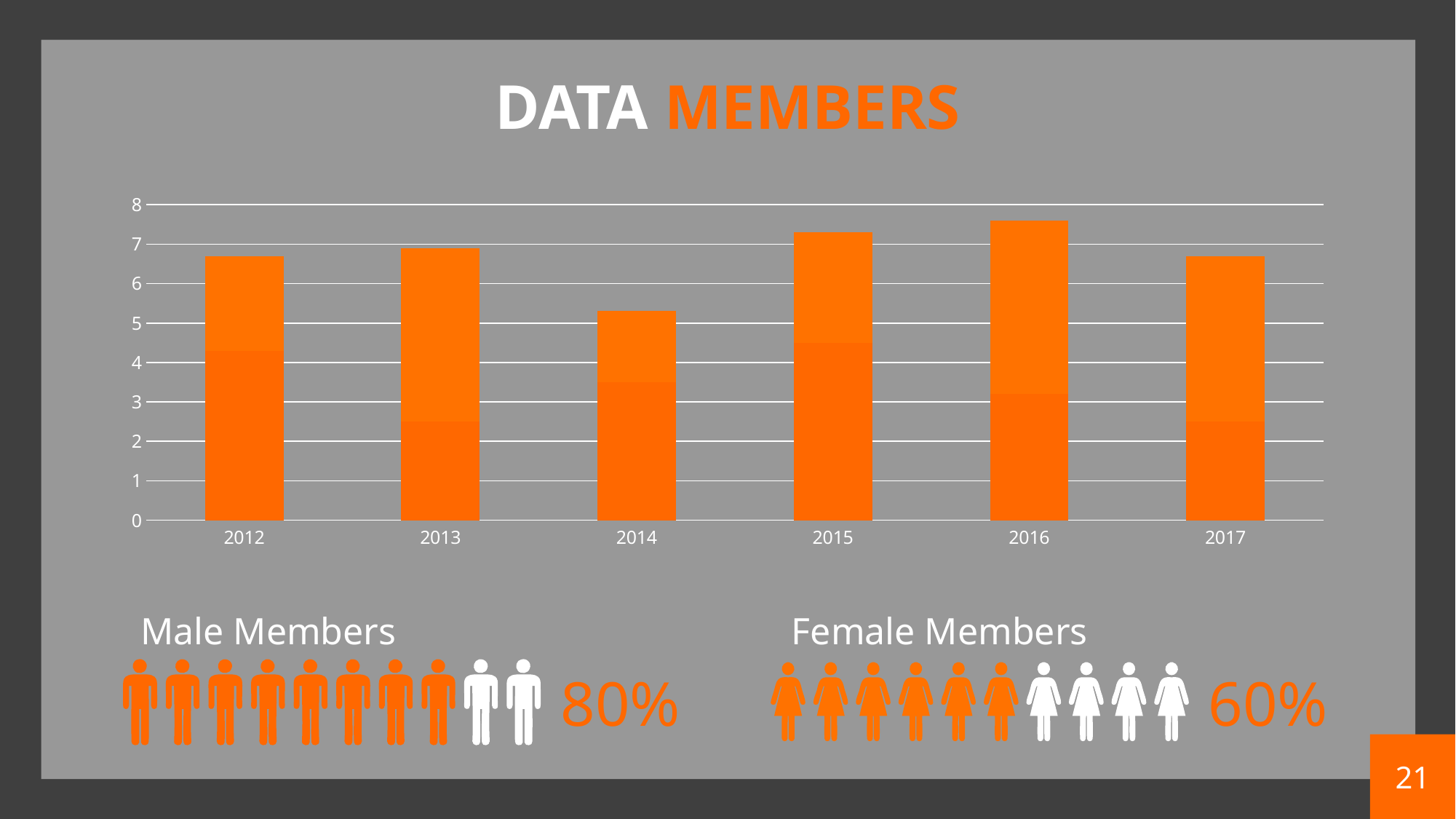
What is the title of the slide containing the chart? DATA MEMBERS Is the total bar height for 2014 greater or less than 6? less How many years are shown on the x axis of the bar chart? 6 Is the lower (darker orange) segment of the 2013 bar greater or less than 3? less Which bar is taller, 2012 or 2014? 2012 What kind of chart is shown on the slide? Stacked bar chart Which year has the tallest bar in the chart? 2016 Which year has the shortest bar in the chart? 2014 Is the total bar height for 2012 greater or less than 7? less What percentage is shown next to the Male Members pictograph below the chart? 80% Which bar is taller, 2014 or 2015? 2015